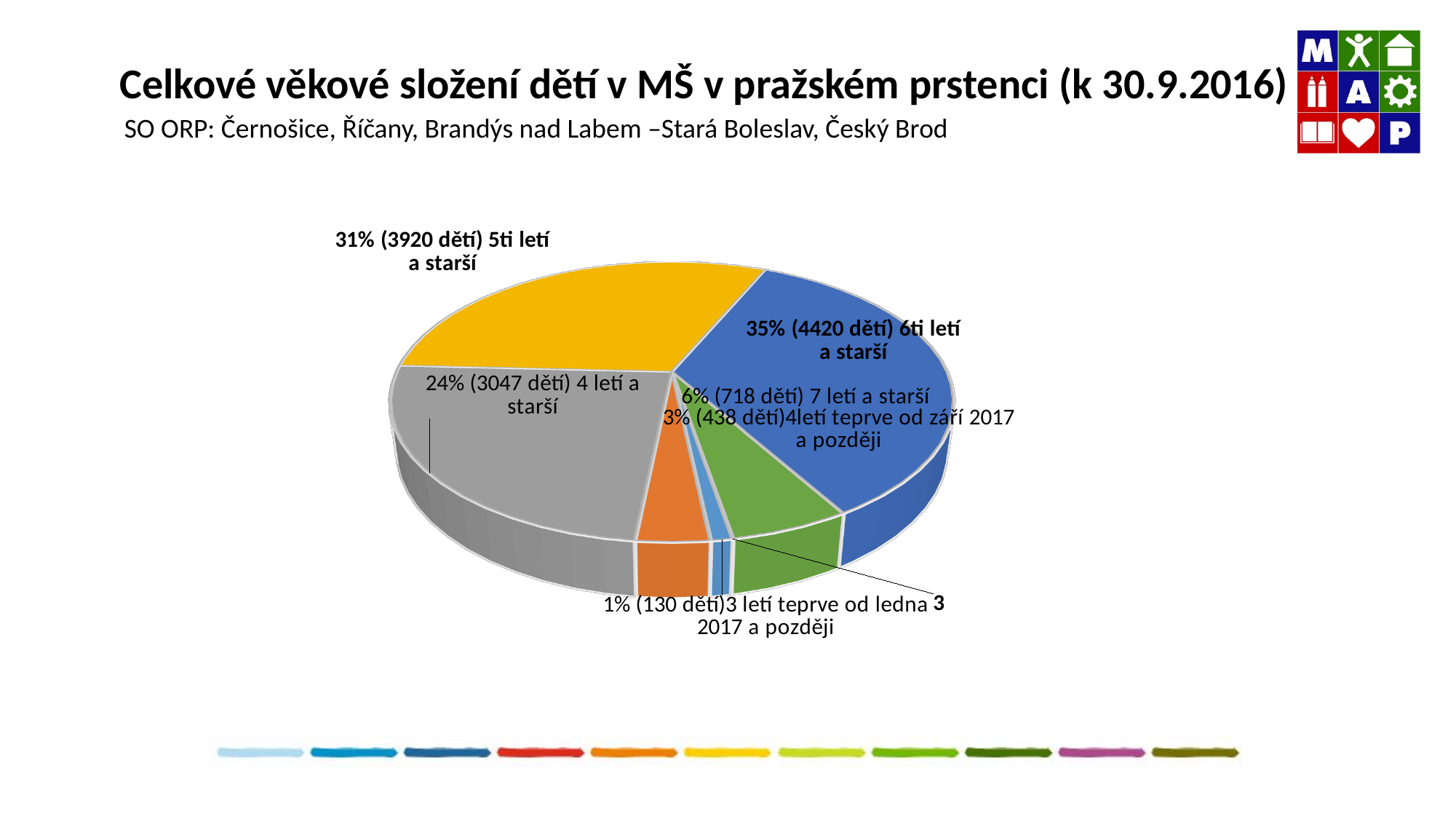
What kind of chart is shown on the slide? pie chart Which group has more children: "4 letí a starší" or "7 letí a starší"? 4 letí a starší What percentage of children are "4 letí a starší"? 24% What is the title of the chart on the slide? Celkové věkové složení dětí v MŠ v pražském prstenci (k 30.9.2016) How many slices does the pie chart have? 7 Which age group has the largest share of the pie? 6ti letí a starší What percentage of children are "6ti letí a starší"? 35% What percentage of children are "4letí teprve od září 2017 a později"? 3% How many children are in the "5ti letí a starší" group? 3920 How many children are in the "7 letí a starší" group? 718 What is the difference in the number of children between the "6ti letí a starší" and "5ti letí a starší" groups? 500